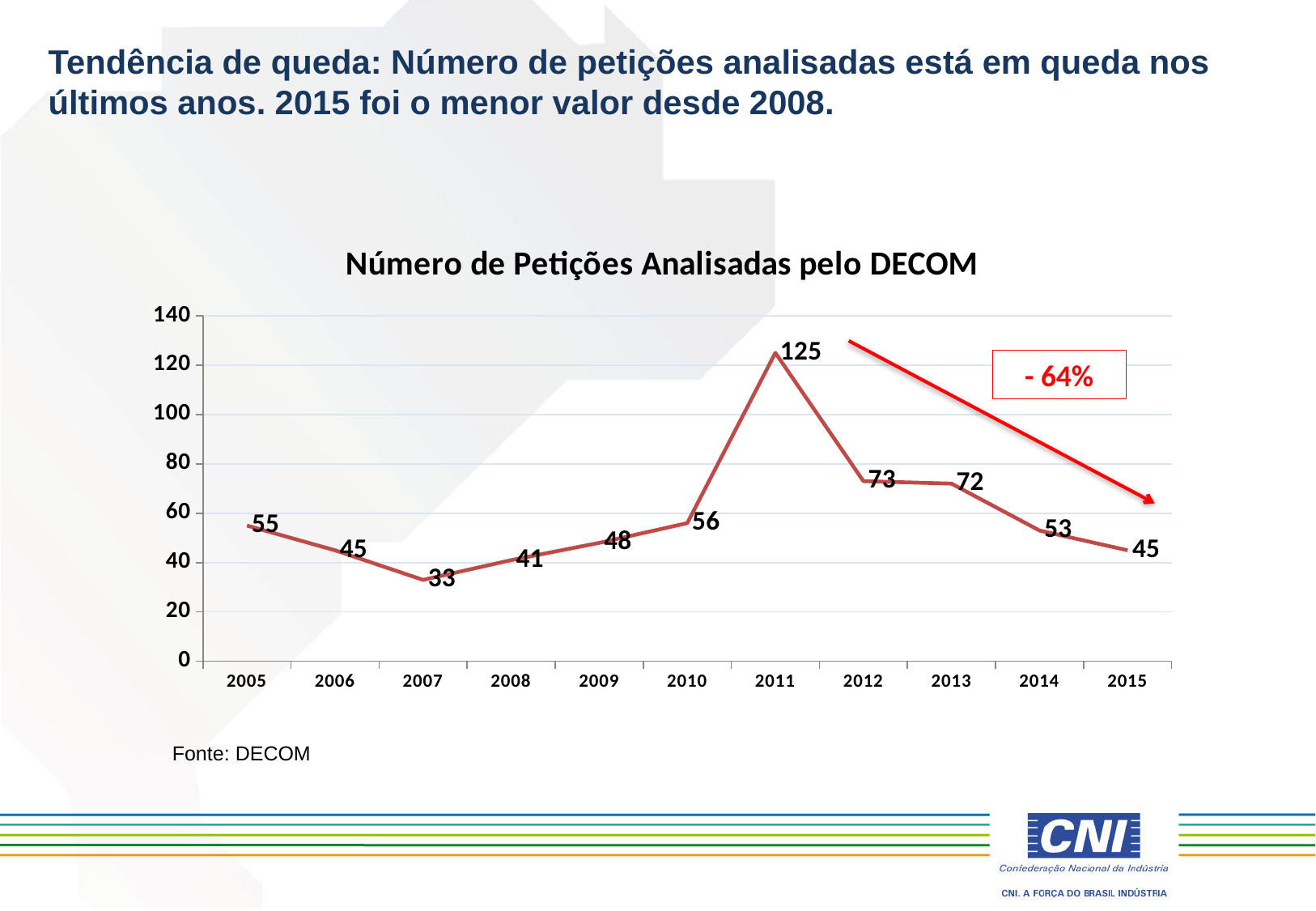
Is the value for 2013 greater or less than 60? greater Which year has the lowest value? 2007 What is the value for 2011? 125 How many years are shown on the x axis? 11 What is the title of the chart? Número de Petições Analisadas pelo DECOM Which year has the highest value? 2011 Do the values rise or fall from 2011 to 2015? fall What is the value for 2007? 33 What kind of chart is this? line chart What is the value for 2015? 45 Which is larger, the value for 2005 or the value for 2009? 2005 What is the difference between the values for 2011 and 2012? 52